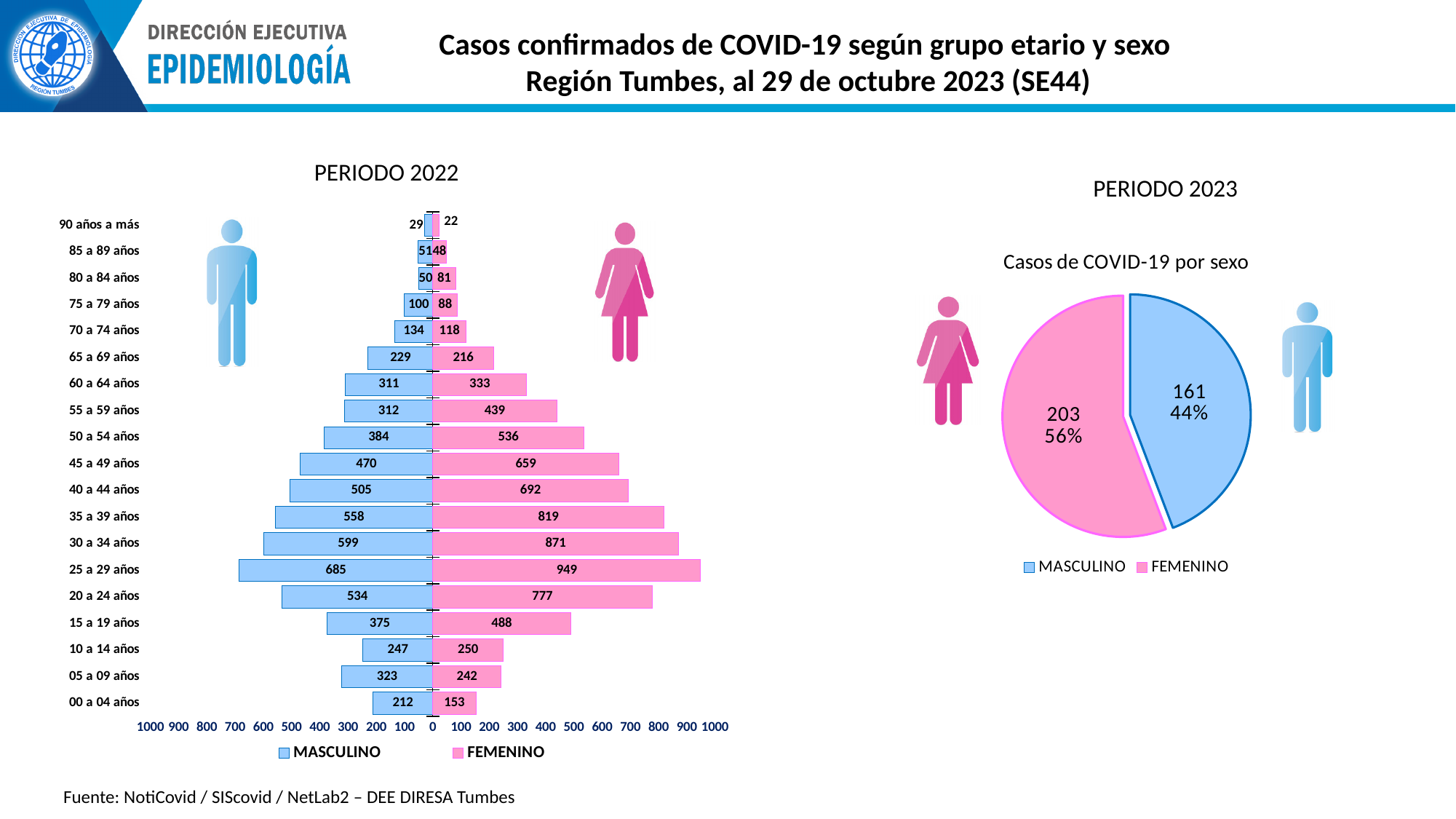
How many series does the legend of the PERIODO 2022 chart list? 2 What kind of chart is the PERIODO 2022 chart? Bar chart How many age groups are shown in the PERIODO 2022 chart? 19 In the PERIODO 2022 chart, which is larger for the 05 a 09 años group, MASCULINO or FEMENINO? MASCULINO In the PERIODO 2022 chart, what is the difference between the FEMENINO and MASCULINO values for the 30 a 34 años group? 272 In the PERIODO 2023 pie chart, what share of cases is MASCULINO? 44% What is the title of the PERIODO 2023 pie chart? Casos de COVID-19 por sexo In the PERIODO 2022 chart, which age group has the highest FEMENINO value? 25 a 29 años In the PERIODO 2022 chart, what is the FEMENINO value for the 35 a 39 años group? 819 In the PERIODO 2022 chart, which age group has the lowest MASCULINO value? 90 años a más In the PERIODO 2022 chart, what is the MASCULINO value for the 25 a 29 años group? 685 In the PERIODO 2023 pie chart, what is the value for FEMENINO? 203